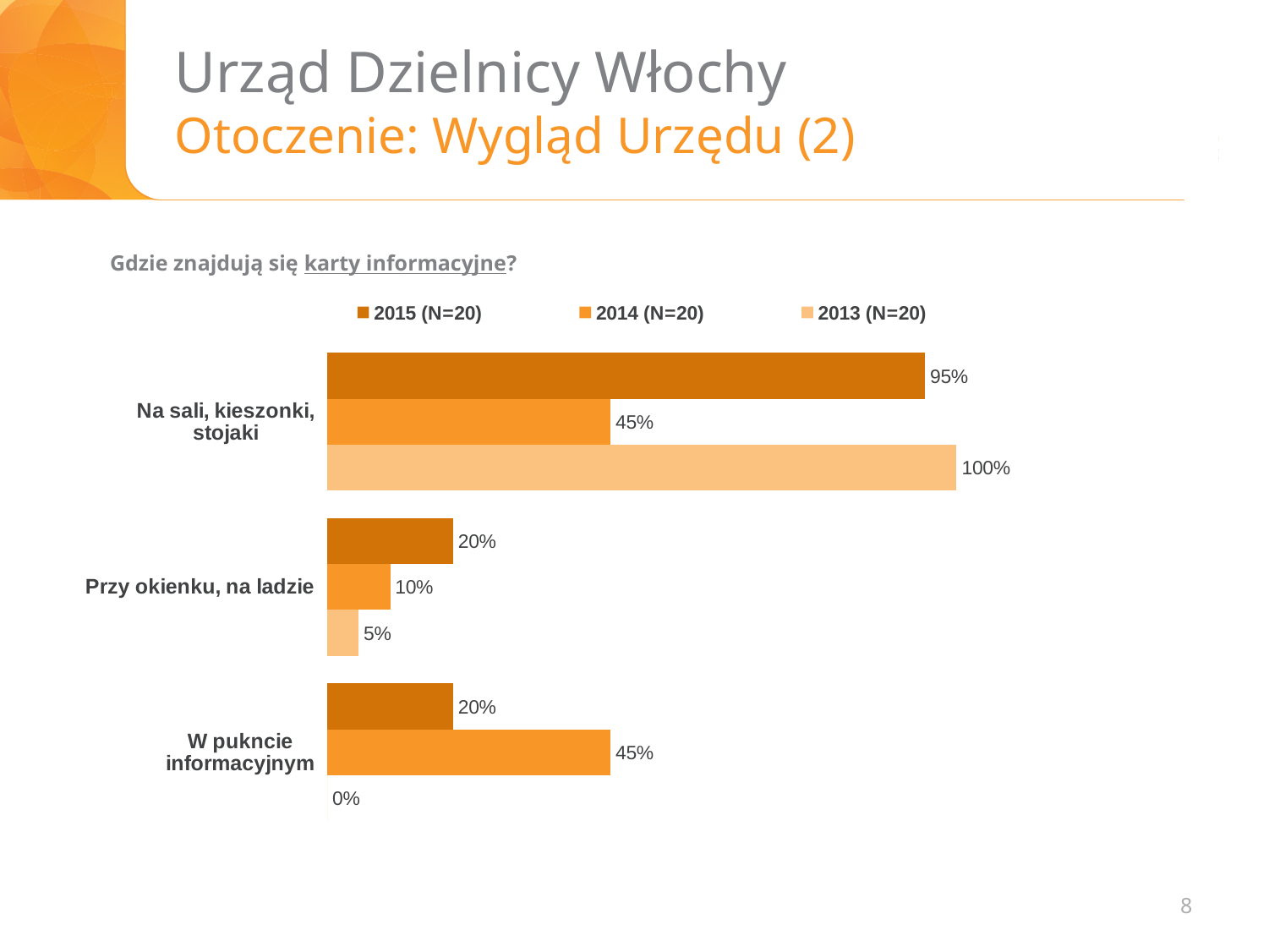
What question does the chart answer, according to the text above it? Gdzie znajdują się karty informacyjne? Which category has the highest value in the 2014 (N=20) series? Na sali, kieszonki, stojaki and W pukncie informacyjnym (both 45%) What is the value for 'W pukncie informacyjnym' in the 2013 (N=20) series? 0% What is the difference between the 2015 and 2014 values for 'Na sali, kieszonki, stojaki'? 50% How many categories are shown on the chart? 3 How many series does the legend list? 3 Which is larger for 'W pukncie informacyjnym': the 2015 value or the 2014 value? 2014 (45%) What is the value for 'Na sali, kieszonki, stojaki' in the 2013 (N=20) series? 100% What is the value for 'Przy okienku, na ladzie' in the 2014 (N=20) series? 10% What kind of chart is shown on the slide? Bar chart Which category has the lowest value in the 2015 (N=20) series? Przy okienku, na ladzie and W pukncie informacyjnym (both 20%) What is the value for 'Na sali, kieszonki, stojaki' in the 2015 (N=20) series? 95%